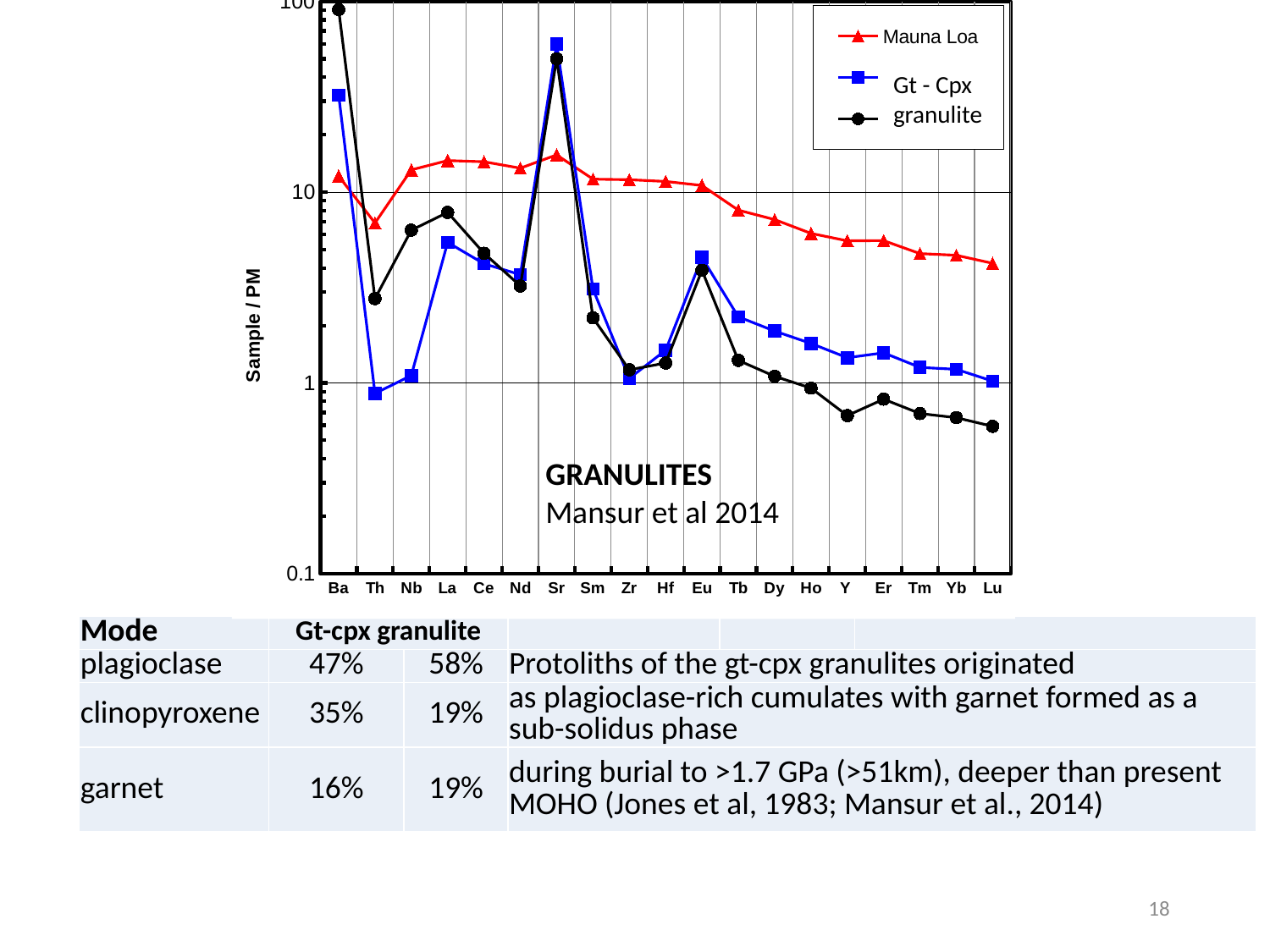
Is the value of the granulite series at Ba greater or less than 10? greater What kind of chart is shown on the slide? line chart Is the value of the Gt - Cpx series at Th greater or less than 1? less Does the Mauna Loa series rise or fall from Tb to Lu? fall How many series does the chart legend list? 3 Which series in the chart is drawn with red triangle markers? Mauna Loa Is the value of the granulite series at Lu greater or less than 1? less At which element does the granulite series reach its highest value? Ba At Ba, which series has the larger value, granulite or Mauna Loa? granulite What is the label of the y axis of the chart? Sample / PM How many elements are plotted along the x axis of the chart? 19